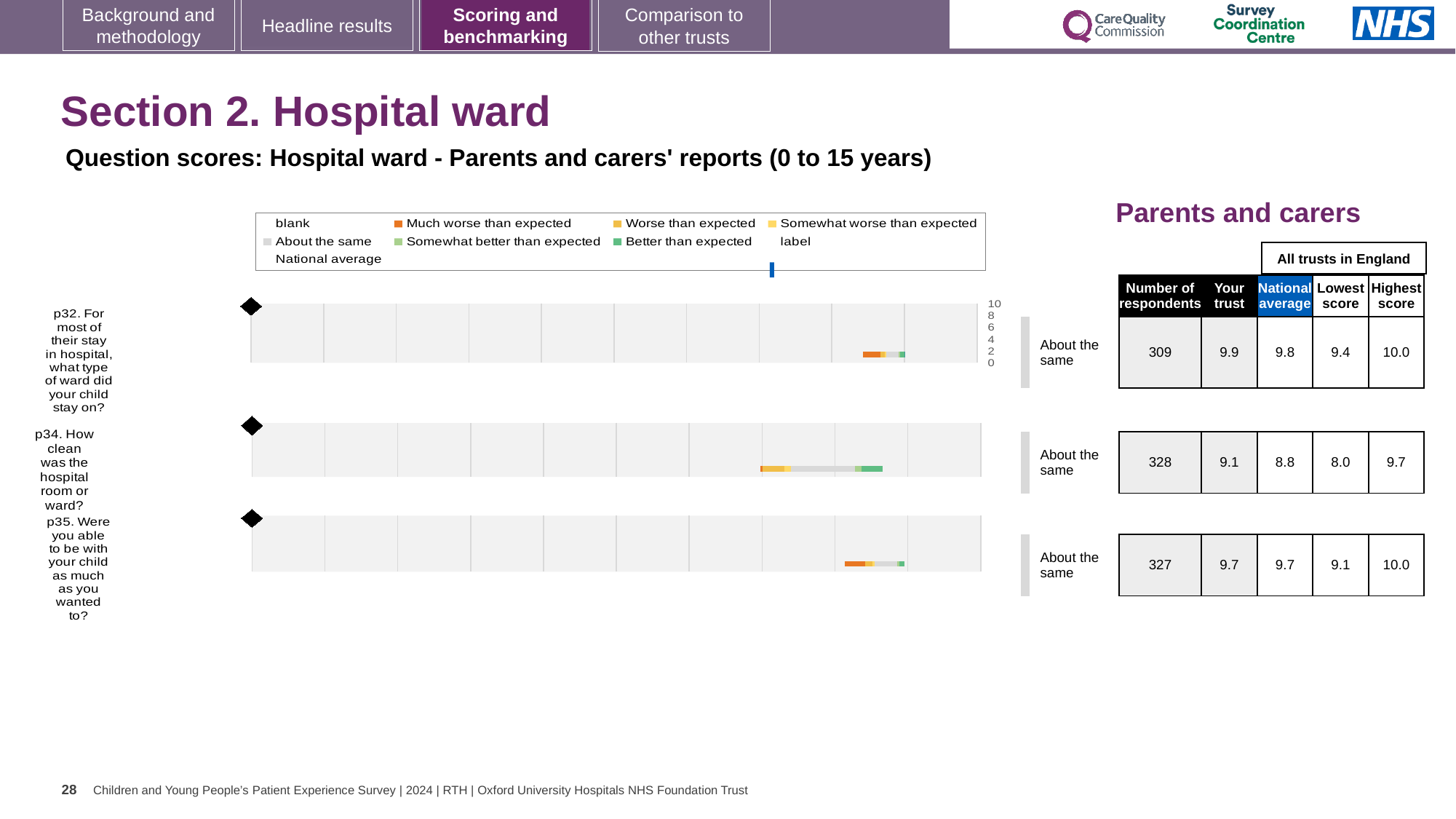
What is the 'Your trust' score for p34 (how clean was the hospital room or ward)? 9.1 What is the lowest score among all trusts in England for p34? 8.0 What is the highest score among all trusts in England for p32? 10.0 What is the number of respondents for p32 (what type of ward did your child stay on)? 309 What is the national average score for p35 (were you able to be with your child as much as you wanted to)? 9.7 How many questions (categories) are plotted in the charts on this slide? 3 Which question has the lowest 'Your trust' score? p34 What is the difference between the 'Your trust' score and the national average for p34? 0.3 For p32, which is larger: the 'Your trust' score or the national average? Your trust What kind of chart is used to show the question scores on this slide? bar chart Which question has the highest 'Your trust' score? p32 What benchmark category is shown next to the chart for p35? About the same